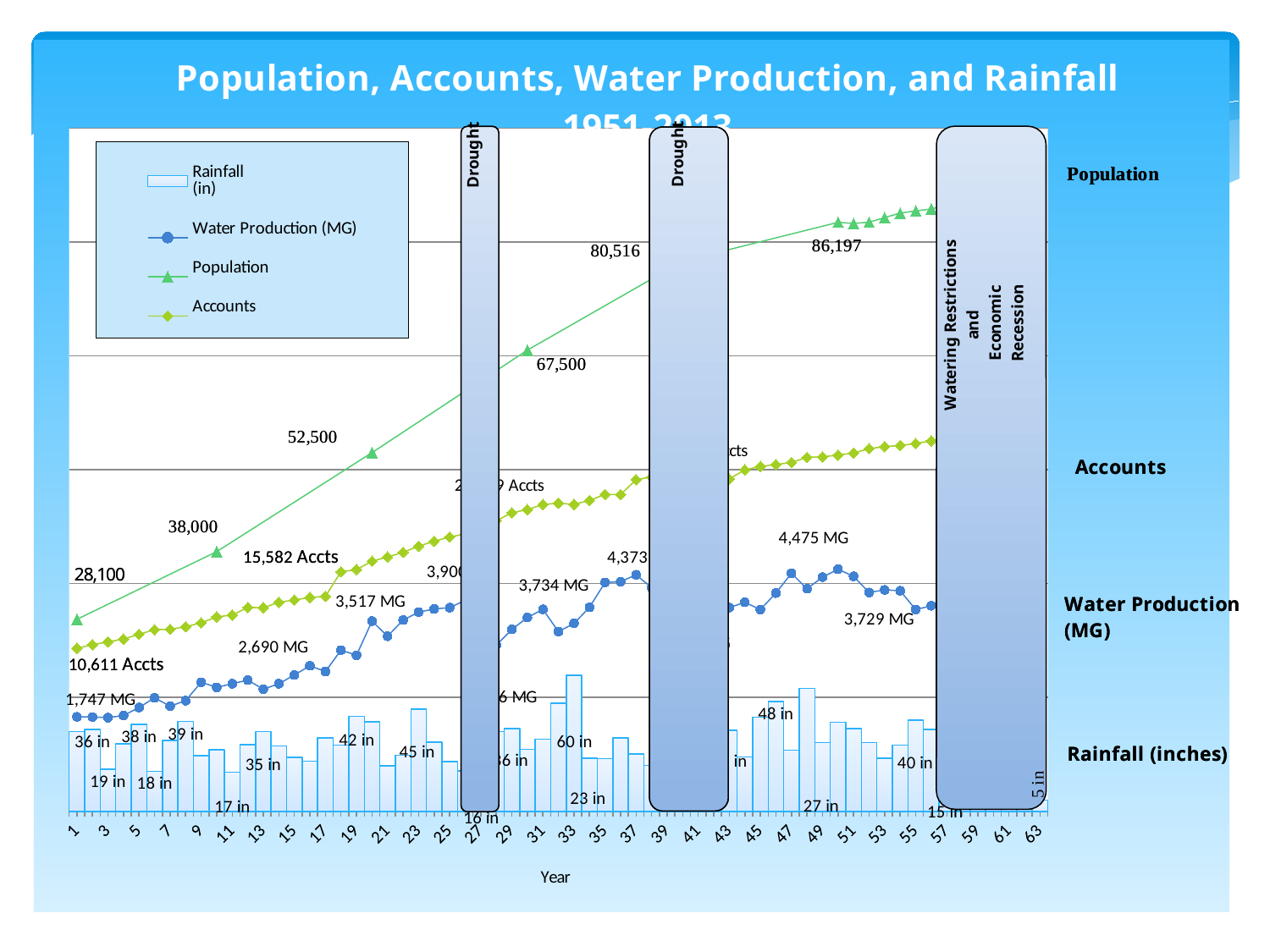
What is the highest labelled Population value on the chart? 86,197 What is the highest labelled Rainfall value on the chart? 60 in What is the first labelled Accounts value at the left of the chart? 10,611 Accts How many series does the legend list? 4 What is the first labelled Population value at the left of the chart? 28,100 What is the first labelled Water Production value at the left of the chart? 1,747 MG What is the title of the x axis? Year What kind of chart is shown on the slide? Combination bar and line chart What is the difference between the Population labels 86,197 and 80,516? 5,681 What is the difference between the Water Production labels 4,475 MG and 3,729 MG? 746 MG Which is larger, the Population label 52,500 or the Population label 67,500? 67,500 What is the highest labelled Water Production value on the chart? 4,475 MG